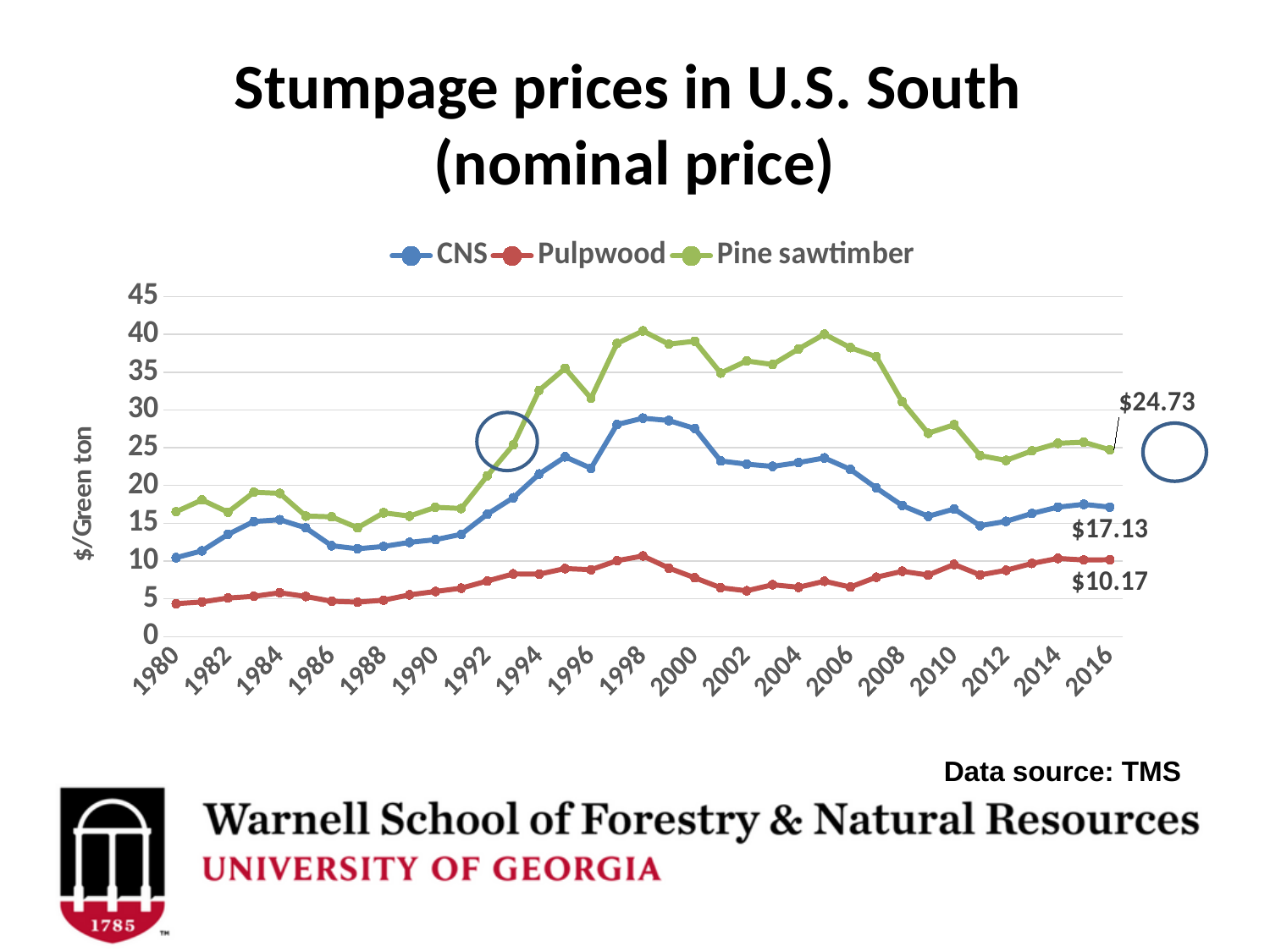
Which series has the lowest values across the whole period? Pulpwood Is the CNS value in 1987 greater or less than 15? less What is the labelled value for Pine sawtimber at the end of the series in 2016? $24.73 What is the labelled value for CNS in 2016? $17.13 What is the labelled value for Pulpwood in 2016? $10.17 Is the Pine sawtimber value in 1998 greater or less than 35? greater What kind of chart is shown on the slide? line chart How many series does the legend list? 3 What is the difference between the 2016 CNS price ($17.13) and the 2016 Pulpwood price ($10.17)? $6.96 What is the difference between the 2016 Pine sawtimber price ($24.73) and the 2016 CNS price ($17.13)? $7.60 Does the Pine sawtimber price rise or fall between 2006 and 2011? fall Which series has the highest value in 2016? Pine sawtimber